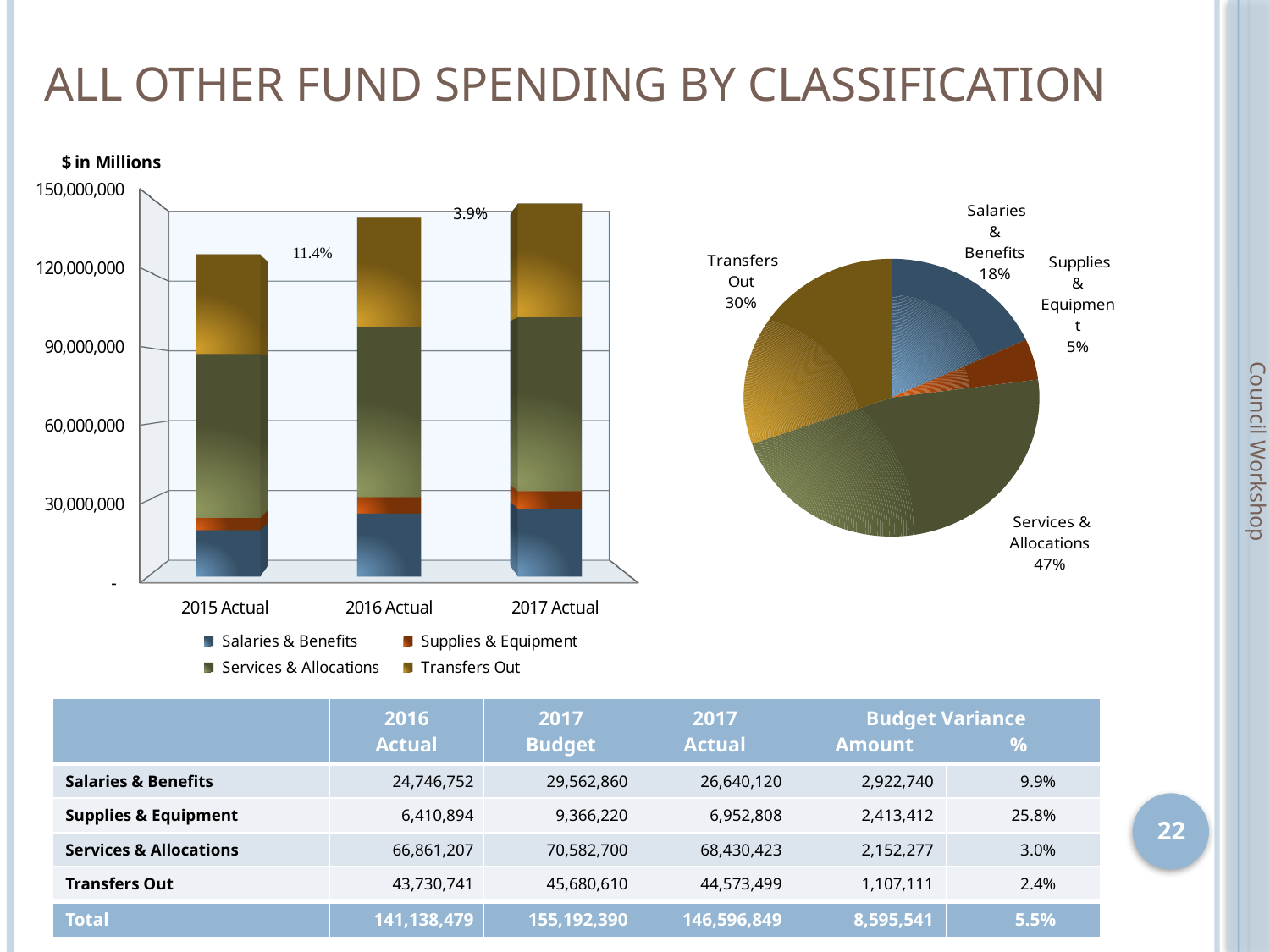
How many series does the legend of the bar chart list? 4 How many categories are shown on the x axis of the bar chart? 3 In the pie chart, which slice is the smallest? Supplies & Equipment In the pie chart, which is larger: Salaries & Benefits or Transfers Out? Transfers Out In the pie chart, what share does Transfers Out have? 30% In the pie chart, which slice is the largest? Services & Allocations What kind of chart is the chart on the right of the slide? Pie chart In the bar chart, do the total bar heights rise or fall from 2015 Actual to 2017 Actual? rise What kind of chart is the chart on the left of the slide? Stacked bar chart In the bar chart, is the total height of the 2015 Actual bar greater or less than 90,000,000? greater In the pie chart, what share does Supplies & Equipment have? 5% In the pie chart, what share does Services & Allocations have? 47%